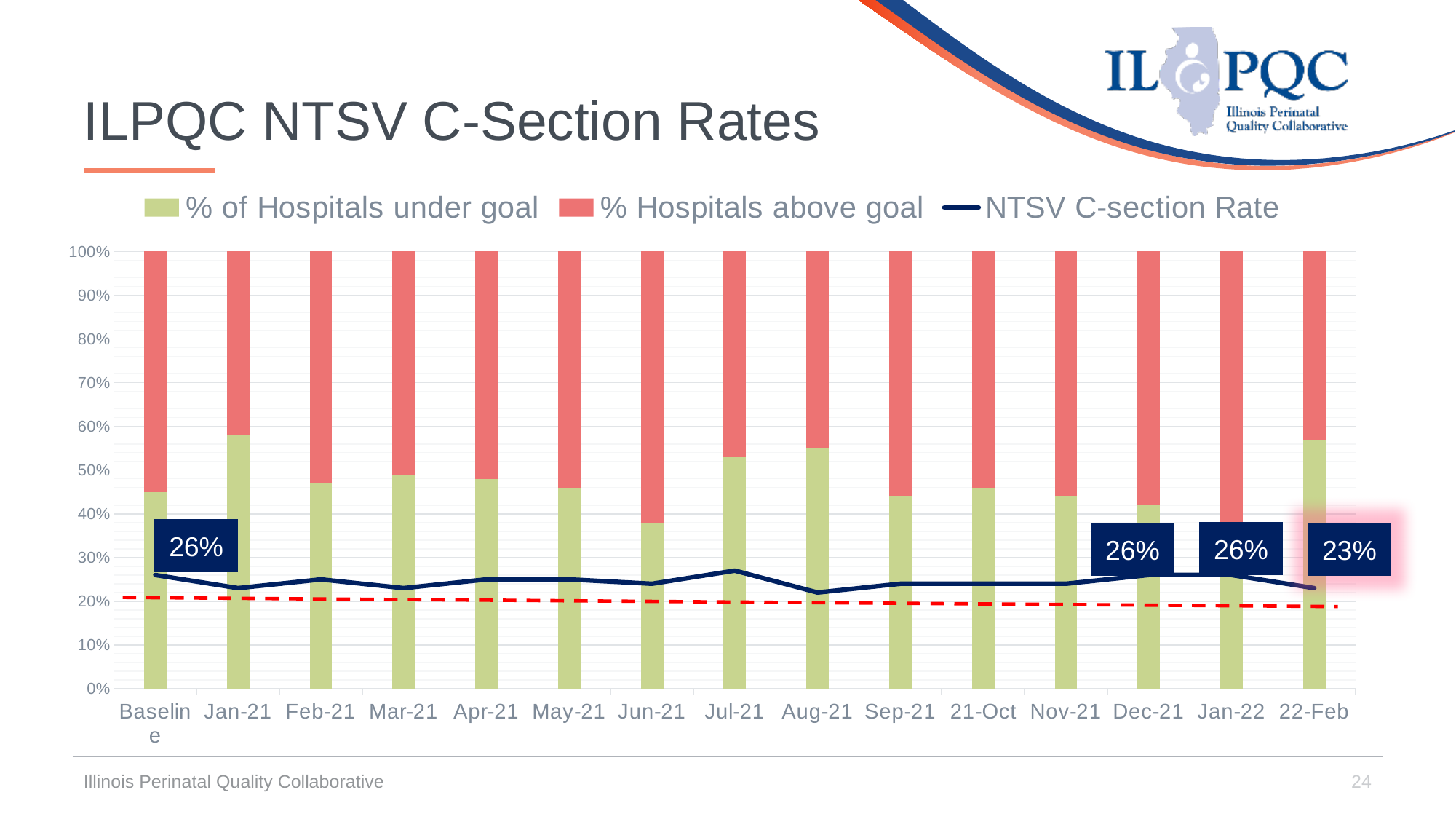
Which of the two is larger: the NTSV C-section Rate at Jan-22 or at 22-Feb? Jan-22 What kind of chart is this? Stacked bar chart with a line How many series does the legend list? 3 How many time periods are shown along the x axis? 15 Is the value for % of Hospitals under goal in Jun-21 greater or less than 40%? less By how many percentage points does the NTSV C-section Rate at 22-Feb differ from the Baseline rate? 3 percentage points What is the NTSV C-section Rate shown for the Baseline period? 26% What is the total of each stacked bar (under goal plus above goal)? 100% What is the NTSV C-section Rate shown for 22-Feb? 23% What is the NTSV C-section Rate shown for Dec-21? 26% In which period is the % of Hospitals under goal the lowest? Jan-22 Is the value for % of Hospitals under goal in Jan-21 greater or less than 50%? greater